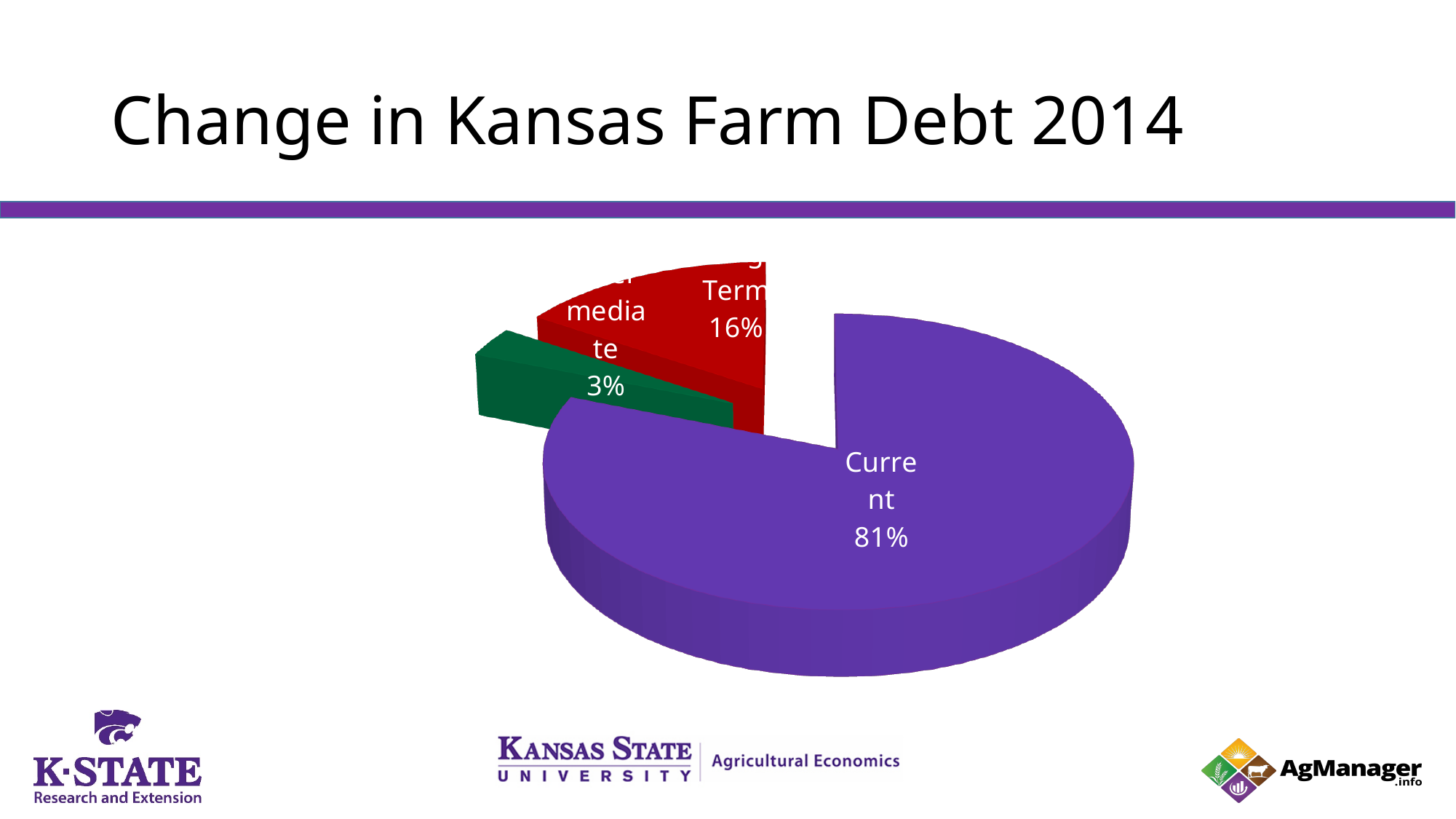
What percentage is shown on the red slice labelled Term? 16% What is the title of the slide containing the pie chart? Change in Kansas Farm Debt 2014 What kind of chart is shown on the slide? pie chart How many slices does the pie chart have? 3 What is the difference in percentage points between the red Term slice and the green Intermediate slice? 13 Which slice of the pie is the smallest? Intermediate Which is larger, the red Term slice or the green Intermediate slice? Term What is the difference in percentage points between the Current slice and the red Term slice? 65 What colour is the Current slice of the pie? purple What share of the pie does the Current slice represent? 81% What percentage is shown on the green Intermediate slice? 3% Which slice of the pie is the largest? Current